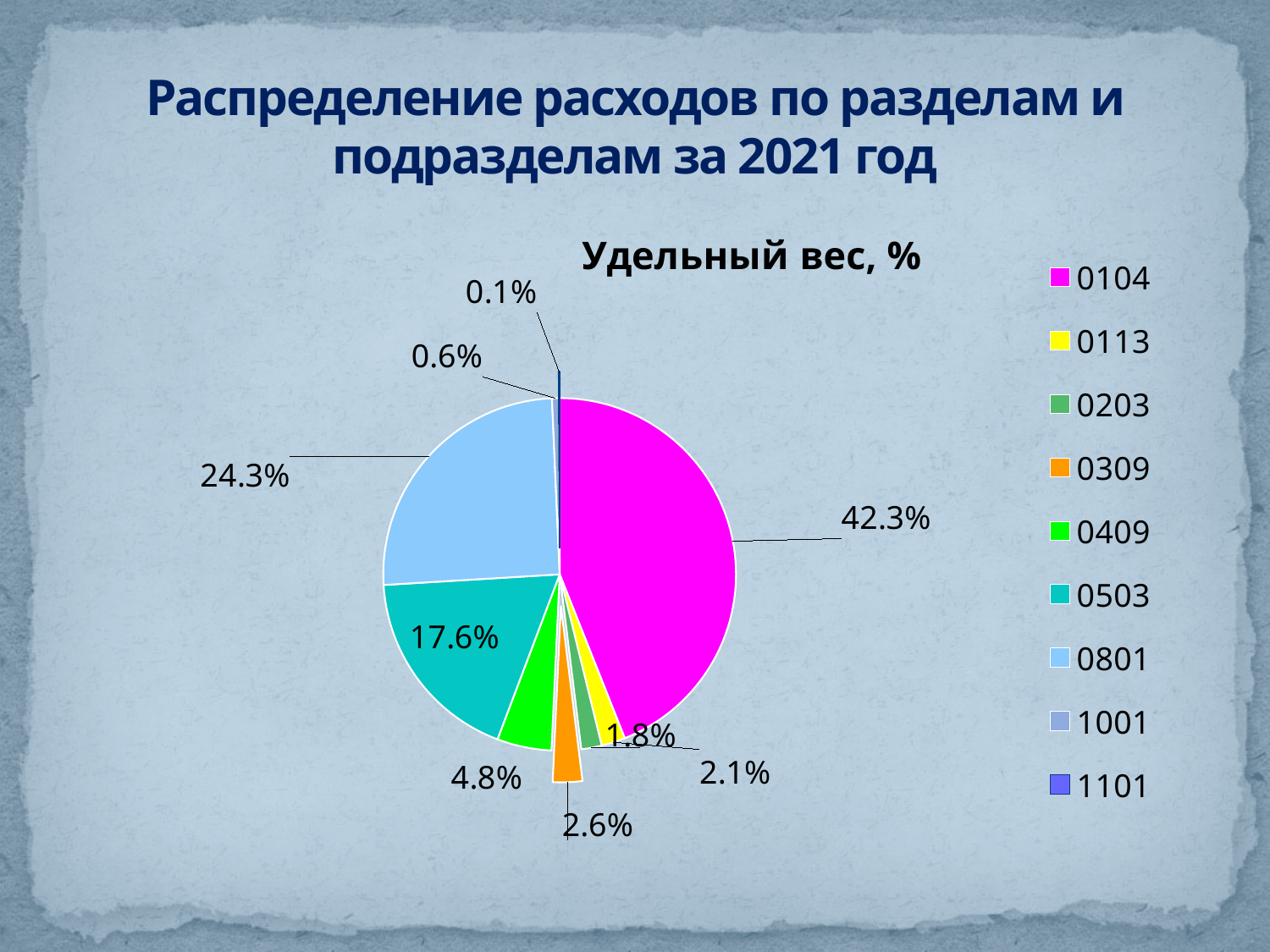
What is the difference between the shares of sections 0104 and 0801? 18.0% What kind of chart is shown on the slide? pie chart How many entries does the chart legend list? 9 What is the title of the chart? Удельный вес, % What share of the pie does section 0104 have? 42.3% What share of the pie does section 0503 have? 17.6% What share of the pie does section 0309 have? 2.6% Which section has the largest share of the pie? 0104 Which section has a larger share, 0503 or 0801? 0801 What share of the pie does section 0409 have? 4.8% Which section has the smallest share of the pie? 1101 What share of the pie does section 0801 have? 24.3%